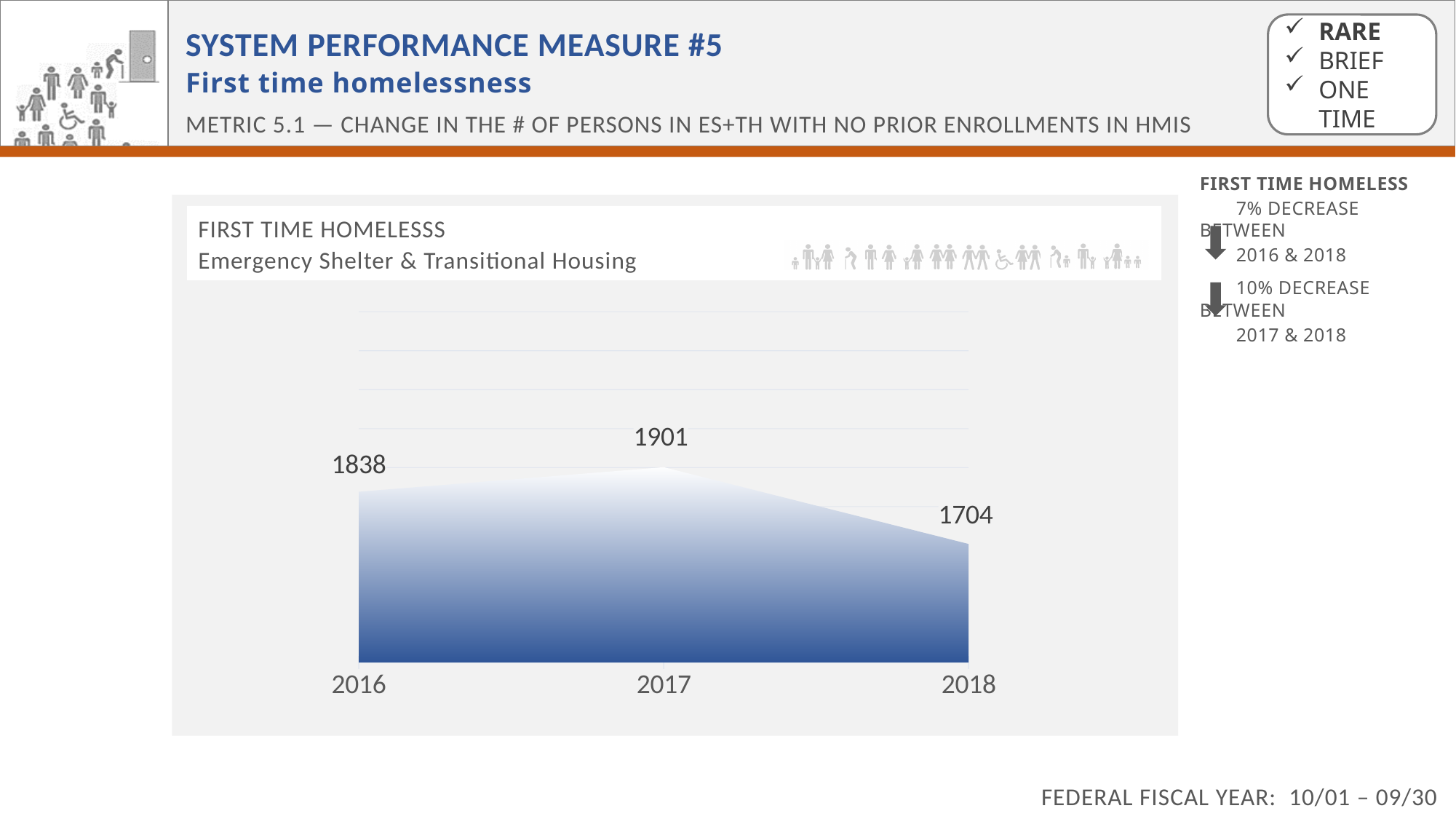
Does the value rise or fall from 2017 to 2018? fall Which year has the highest value? 2017 What is the value for 2018? 1704 What kind of chart is shown? area chart What is the difference between the 2016 and 2018 values? 134 What is the subtitle of the chart below 'FIRST TIME HOMELESSS'? Emergency Shelter & Transitional Housing What is the difference between the 2017 and 2018 values? 197 Which year has the lowest value? 2018 What is the value for 2017? 1901 How many years are plotted on the chart? 3 Which is larger, the value for 2016 or the value for 2018? 2016 What is the value for 2016? 1838